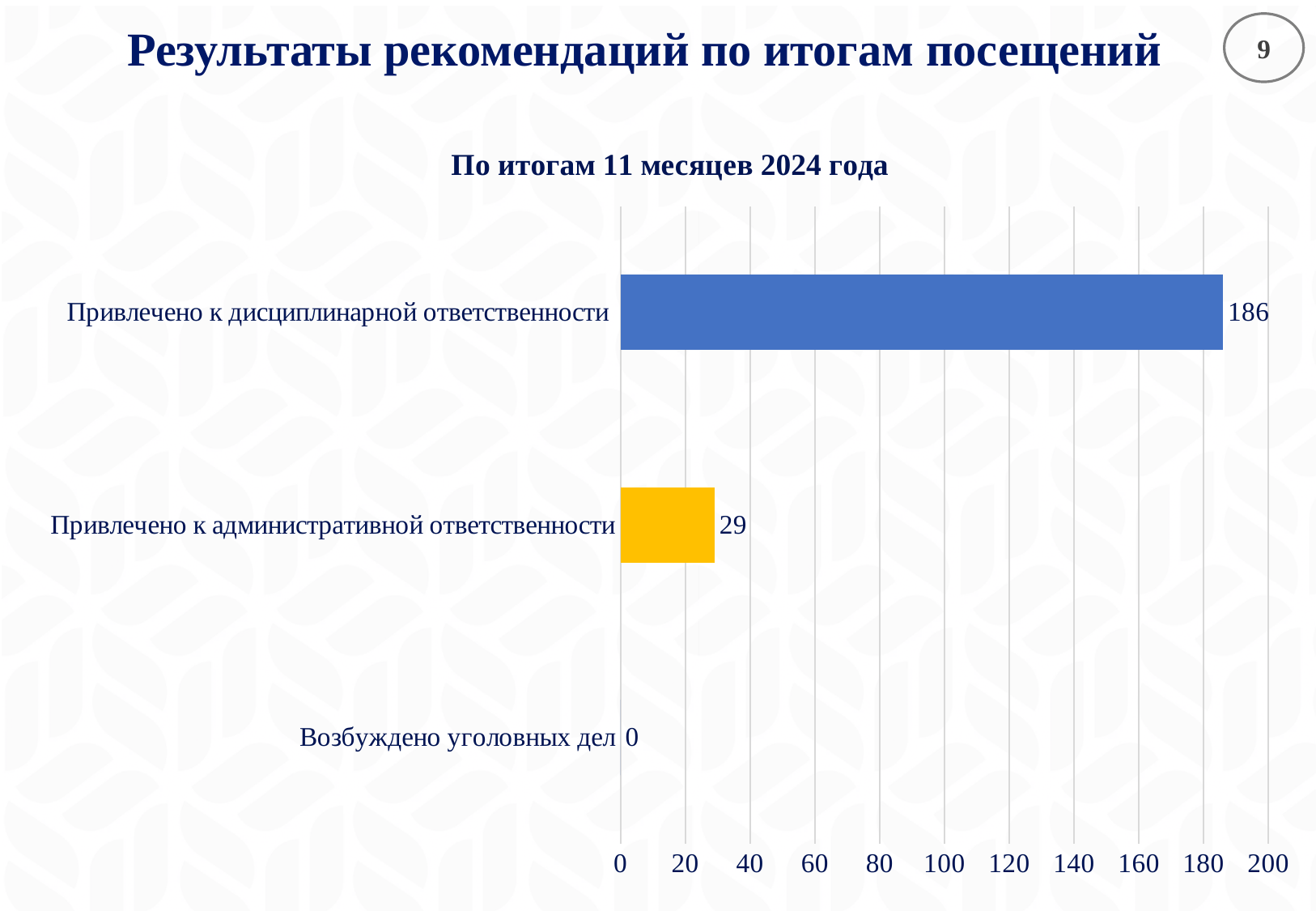
What is the value for "Привлечено к дисциплинарной ответственности"? 186 Is the value for "Привлечено к административной ответственности" greater or less than 40? less Which is larger: the value for "Привлечено к административной ответственности" or the value for "Возбуждено уголовных дел"? Привлечено к административной ответственности Which category has the lowest value? Возбуждено уголовных дел What is the title of the chart? По итогам 11 месяцев 2024 года How many categories are shown in the chart? 3 Which category has the highest value? Привлечено к дисциплинарной ответственности What is the value for "Возбуждено уголовных дел"? 0 What kind of chart is shown on the slide? bar chart Is the value for "Привлечено к дисциплинарной ответственности" greater or less than 180? greater What is the value for "Привлечено к административной ответственности"? 29 What is the difference between the values for "Привлечено к дисциплинарной ответственности" and "Привлечено к административной ответственности"? 157